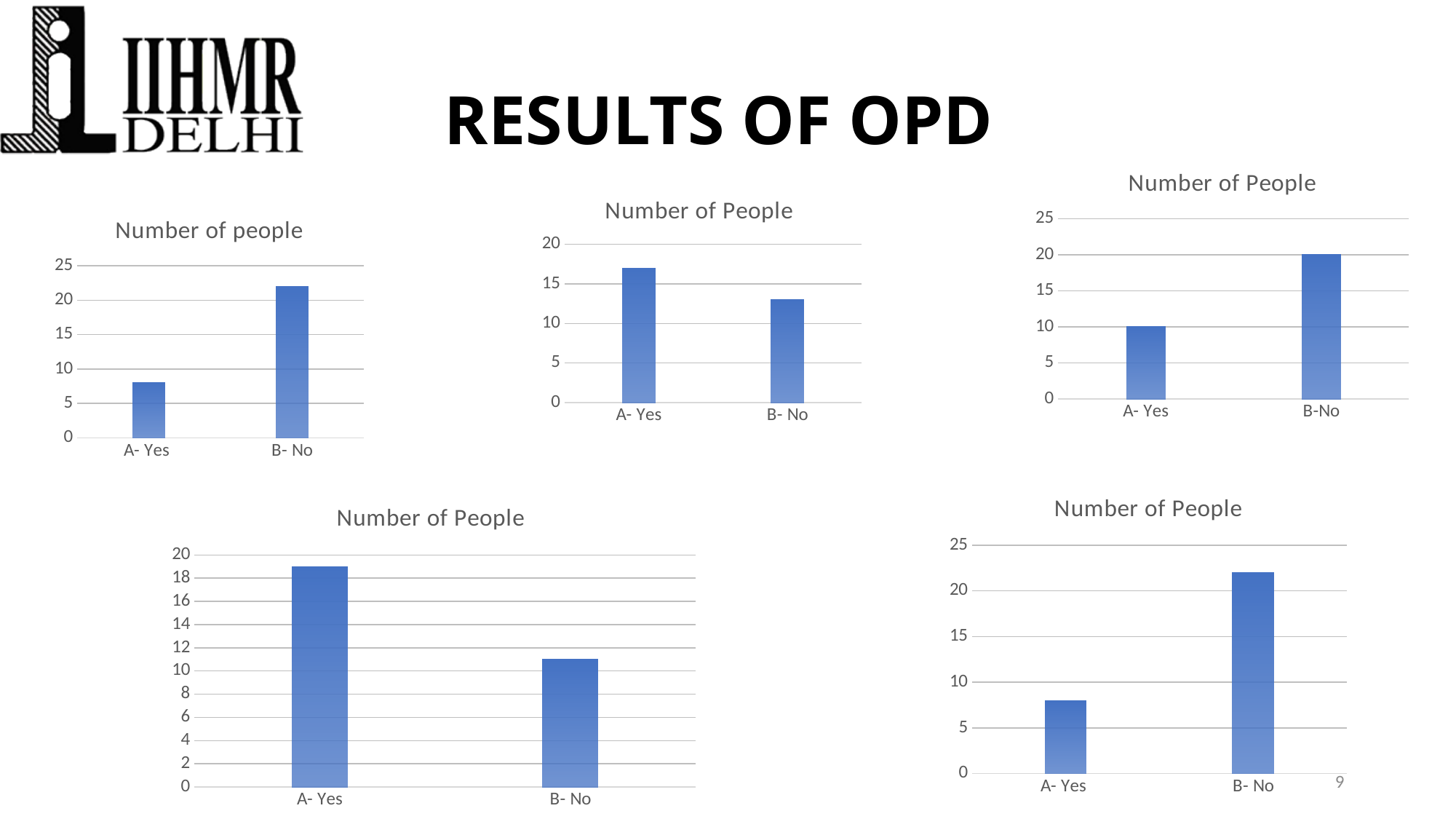
In the bottom-right chart, which is larger, the value for A- Yes or B- No? B- No What kind of chart is the top-left chart? bar chart In the top-right chart, what is the value for A- Yes? 10 In the bottom-left chart, is the value for A- Yes greater or less than 18? greater In the top-left chart, is the value for A- Yes greater or less than 10? less In the bottom-left chart, which category has the lowest value? B- No In the top-middle chart, which category has the highest value? A- Yes In the top-middle chart, is the value for A- Yes greater or less than 15? greater In the top-right chart, what is the difference between the values for B-No and A- Yes? 10 In the top-right chart, what is the value for B-No? 20 How many categories does the bottom-right chart show? 2